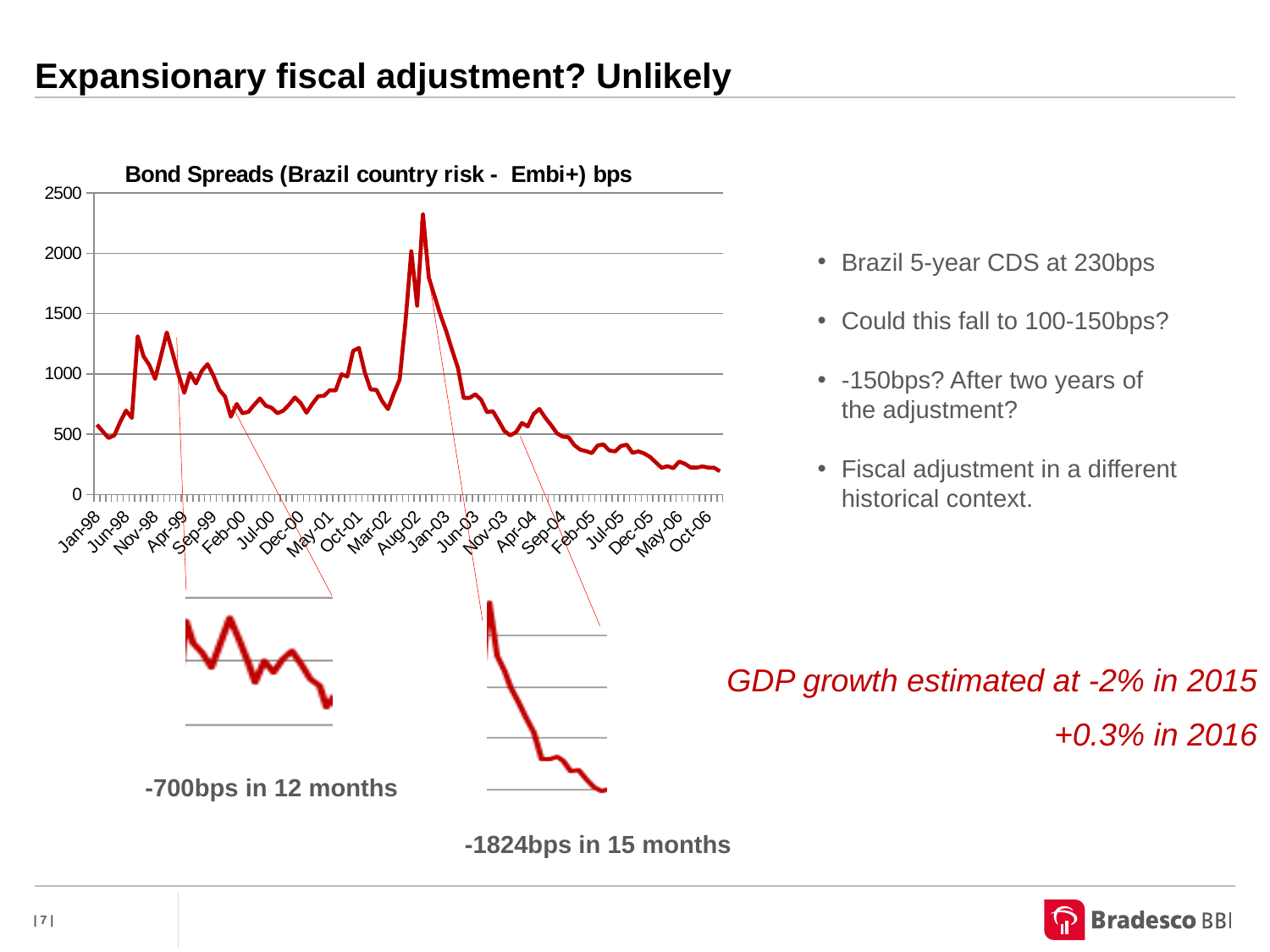
In the Bond Spreads chart, is the value at Oct-06 greater or less than 500? less In the Bond Spreads chart, is the value at Jul-05 greater or less than 1000? less How many data series are plotted in the Bond Spreads chart? 1 In the Bond Spreads chart, which period has the higher spread: around Aug-02 or around Oct-06? around Aug-02 In the Bond Spreads chart, is the value at Mar-02 greater or less than 500? greater In the Bond Spreads chart, do the values rise or fall from Jan-03 to Oct-06? fall What is the title of the main chart on the slide? Bond Spreads (Brazil country risk - Embi+) bps What kind of chart is the 'Bond Spreads (Brazil country risk - Embi+) bps' chart? line chart What is the highest value shown on the y axis of the Bond Spreads chart? 2500